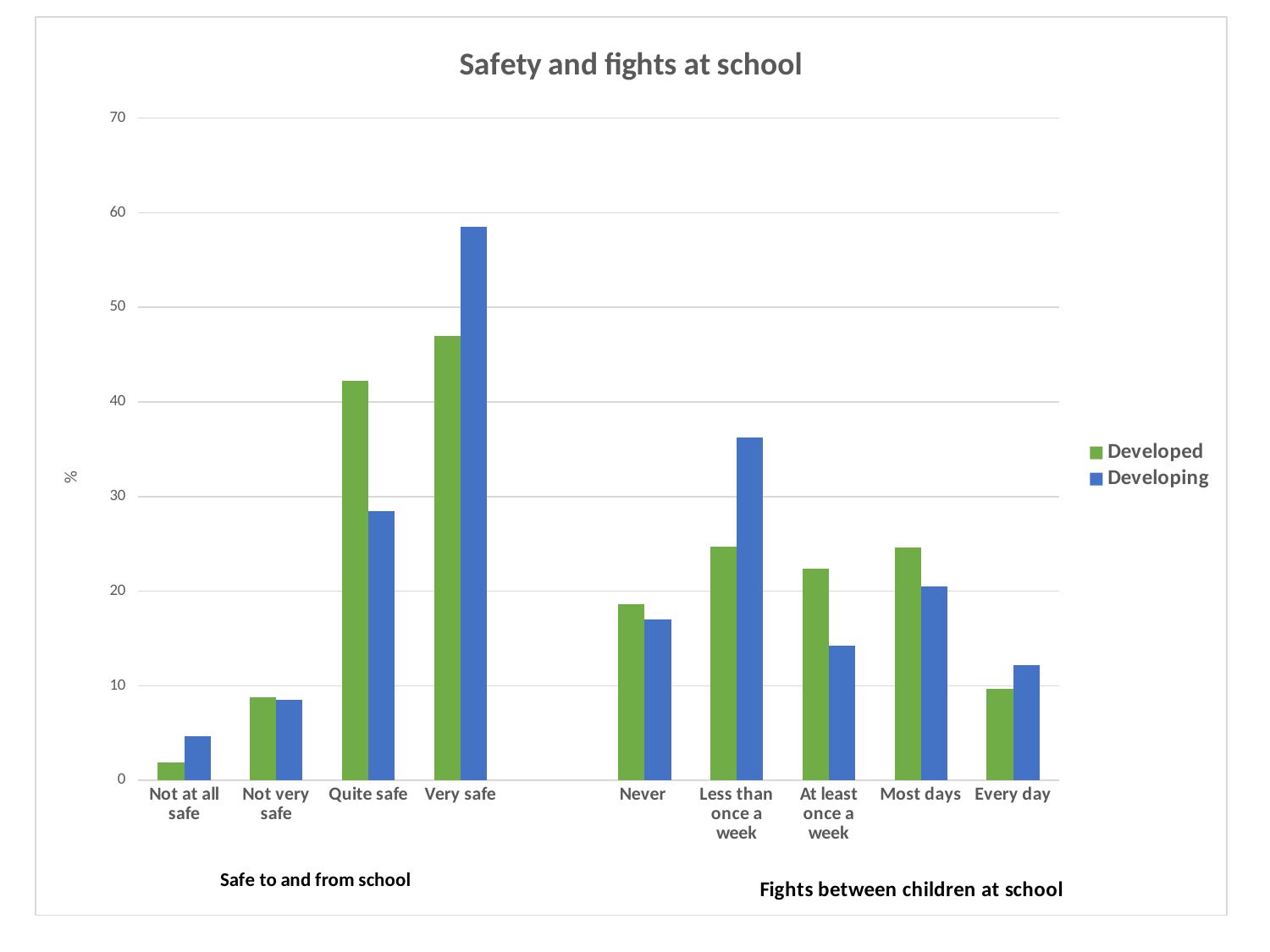
Is the Developed value for Quite safe greater or less than 40? greater For Less than once a week, which series has the larger value, Developed or Developing? Developing For which category is the Developed series lowest? Not at all safe Is the Developing value for Very safe greater or less than 50? greater How many series does the legend list? 2 For which category is the Developing series highest? Very safe Is the Developing value for At least once a week greater or less than 20? less For Quite safe, which series has the larger value, Developed or Developing? Developed How many categories are shown along the x axis? 9 What is the title of the chart? Safety and fights at school What kind of chart is shown on the slide? bar chart